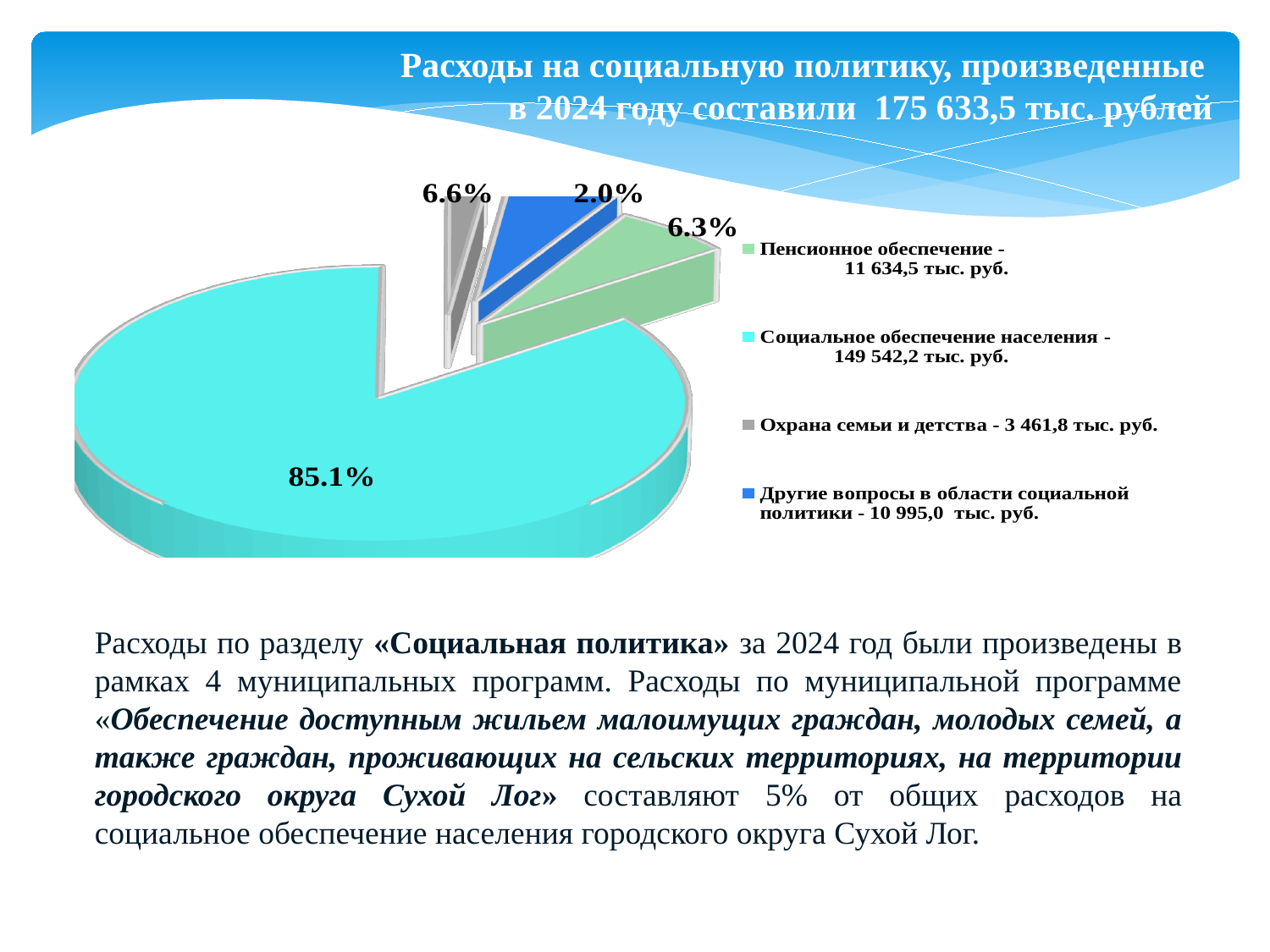
According to the legend, what is the value for Другие вопросы в области социальной политики? 10 995,0 тыс. руб. According to the legend, what is the value for Пенсионное обеспечение? 11 634,5 тыс. руб. Which category has the smallest value in the legend? Охрана семьи и детства Which is larger: the value for Пенсионное обеспечение or the value for Другие вопросы в области социальной политики? Пенсионное обеспечение Which category has the largest share of the pie chart? Социальное обеспечение населения How many slices does the pie chart have? 4 What total amount of social policy expenditure in 2024 is stated in the chart title? 175 633,5 тыс. рублей According to the legend, what is the value for Охрана семьи и детства? 3 461,8 тыс. руб. What percentage share does the largest slice of the pie chart have? 85.1% According to the legend, what is the value for Социальное обеспечение населения? 149 542,2 тыс. руб. How many entries does the legend of the pie chart list? 4 What kind of chart is shown on the slide? pie chart